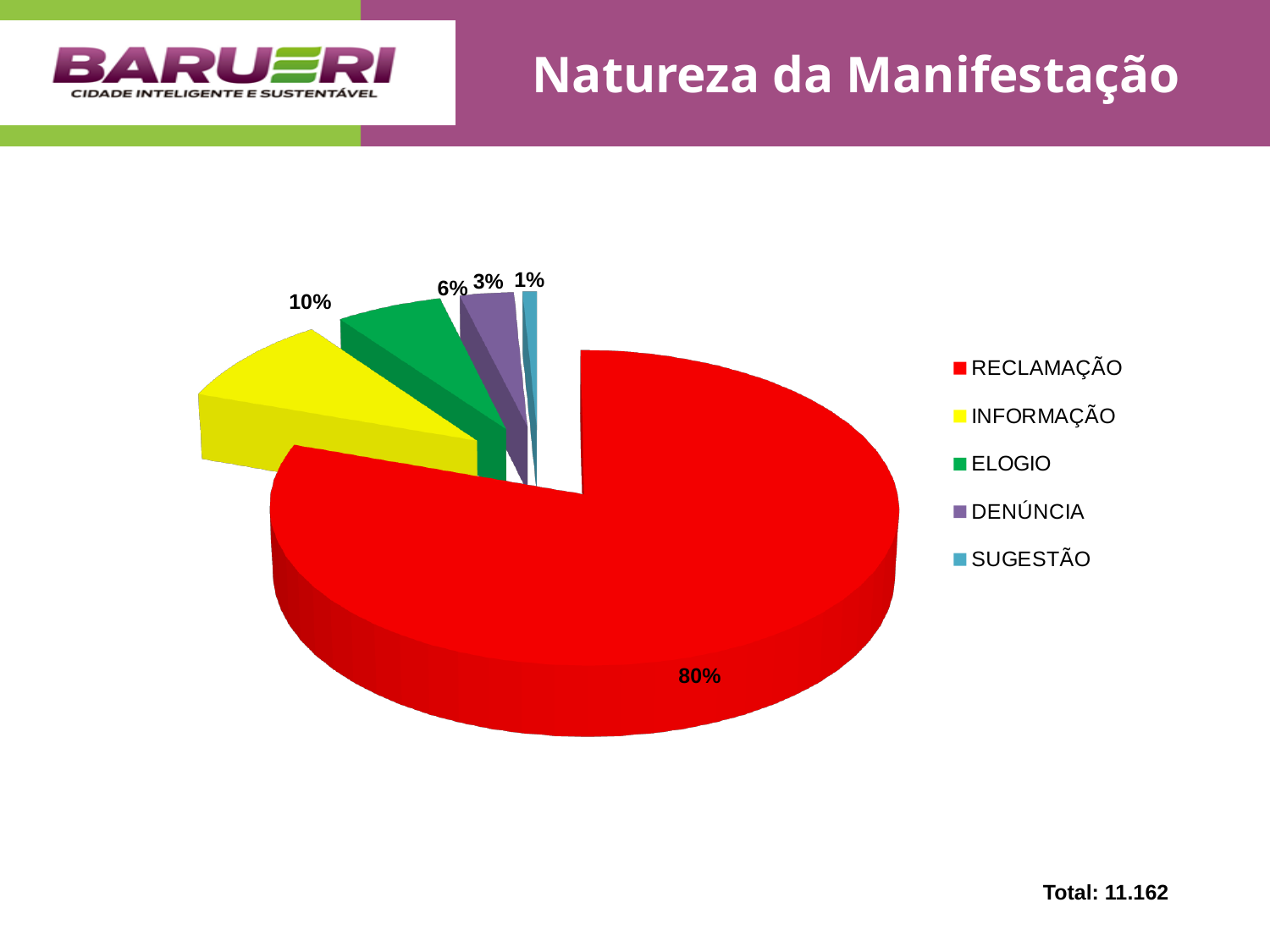
What share of the pie does DENÚNCIA represent? 3% What share of the pie does SUGESTÃO represent? 1% What share of the pie does RECLAMAÇÃO represent? 80% What is the title of the chart on the slide? Natureza da Manifestação What kind of chart is shown on the slide? Pie chart What is the difference in percentage points between RECLAMAÇÃO and INFORMAÇÃO? 70 Which category has the largest slice of the pie? RECLAMAÇÃO Which is larger, the share for ELOGIO or the share for DENÚNCIA? ELOGIO Which category has the smallest slice of the pie? SUGESTÃO How many categories does the pie chart show? 5